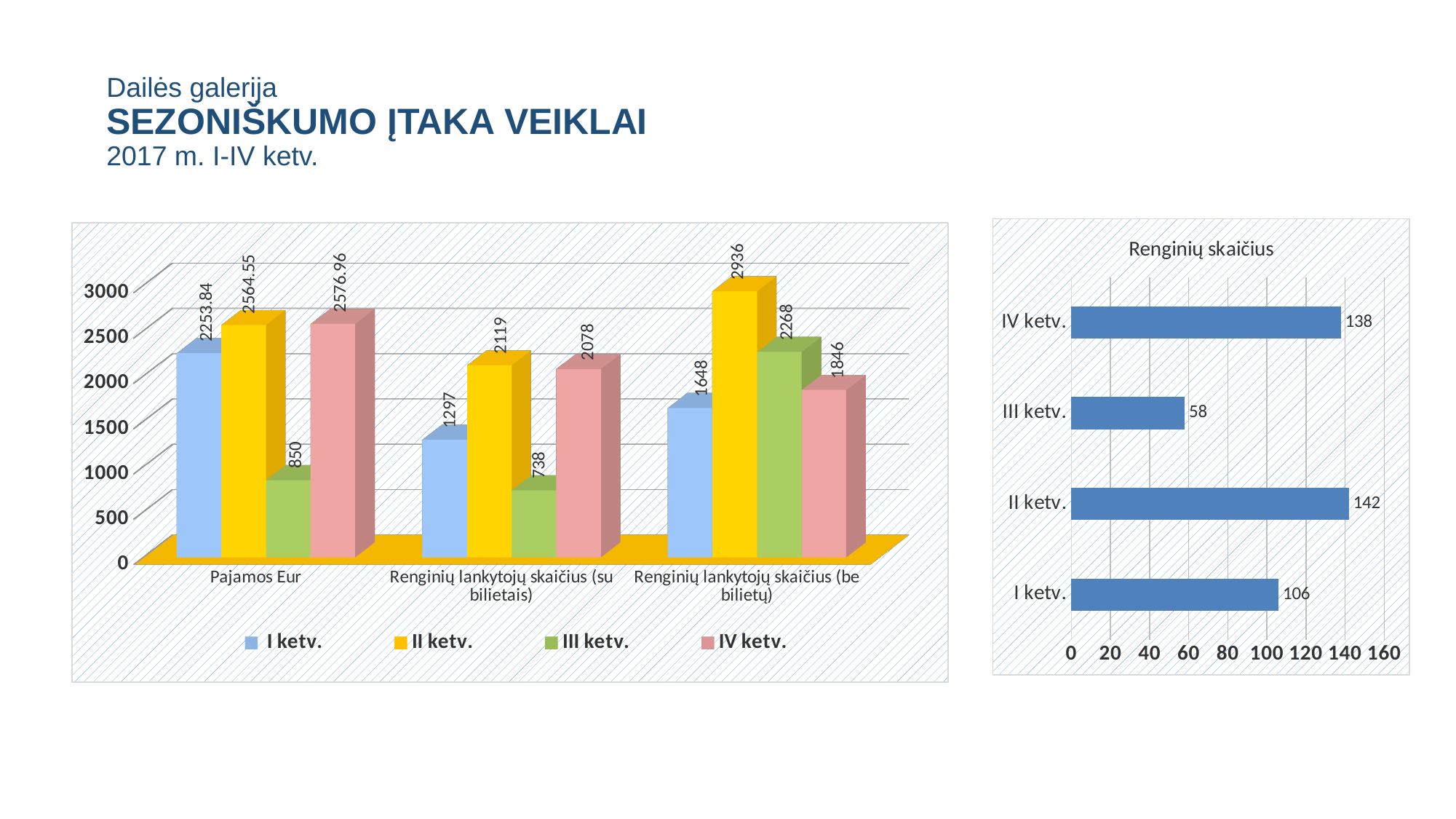
In the left chart, which series has the highest value for Renginių lankytojų skaičius (be bilietų)? II ketv. In the left chart, what is the difference between the II ketv. and I ketv. values for Renginių lankytojų skaičius (su bilietais)? 822 In the chart titled "Renginių skaičius", what is the value for II ketv.? 142 In the left chart, what is the value of the II ketv. series for Pajamos Eur? 2564.55 What kind of chart is the chart titled "Renginių skaičius"? bar chart In the left chart, which colour represents the II ketv. series? yellow In the chart titled "Renginių skaičius", which quarter has the lowest value? III ketv. In the left chart, which is larger for Pajamos Eur: the I ketv. value or the IV ketv. value? IV ketv. How many series does the legend of the left chart list? 4 In the left chart, what is the value of the III ketv. series for Renginių lankytojų skaičius (su bilietais)? 738 In the chart titled "Renginių skaičius", how many categories are shown? 4 In the chart titled "Renginių skaičius", what is the difference between the values for IV ketv. and I ketv.? 32